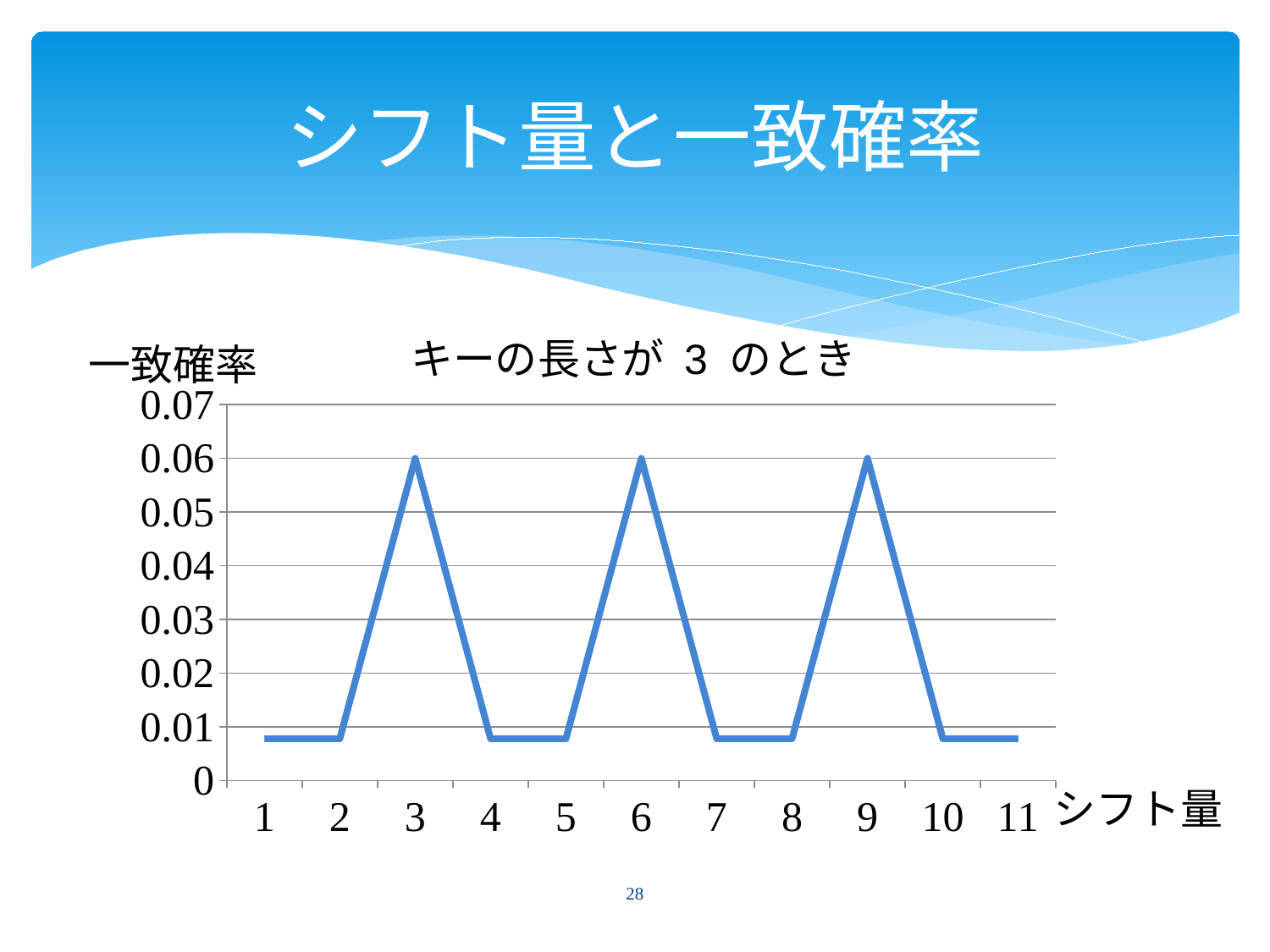
What is the 一致確率 value at シフト量 6? 0.06 Is the 一致確率 value at シフト量 1 greater or less than 0.03? less At which シフト量 values does the chart reach its highest 一致確率? 3, 6, 9 What kind of chart is shown on the slide? line chart Does the 一致確率 rise or fall from シフト量 2 to シフト量 3? rise What is the 一致確率 value at シフト量 9? 0.06 Which has the larger 一致確率, シフト量 3 or シフト量 4? シフト量 3 What is the label of the x axis of the chart? シフト量 What is the 一致確率 value at シフト量 3? 0.06 Is the 一致確率 value at シフト量 4 greater or less than 0.02? less What is the title of the chart? キーの長さが 3 のとき How many shift amounts (x-axis points) are plotted on the chart? 11